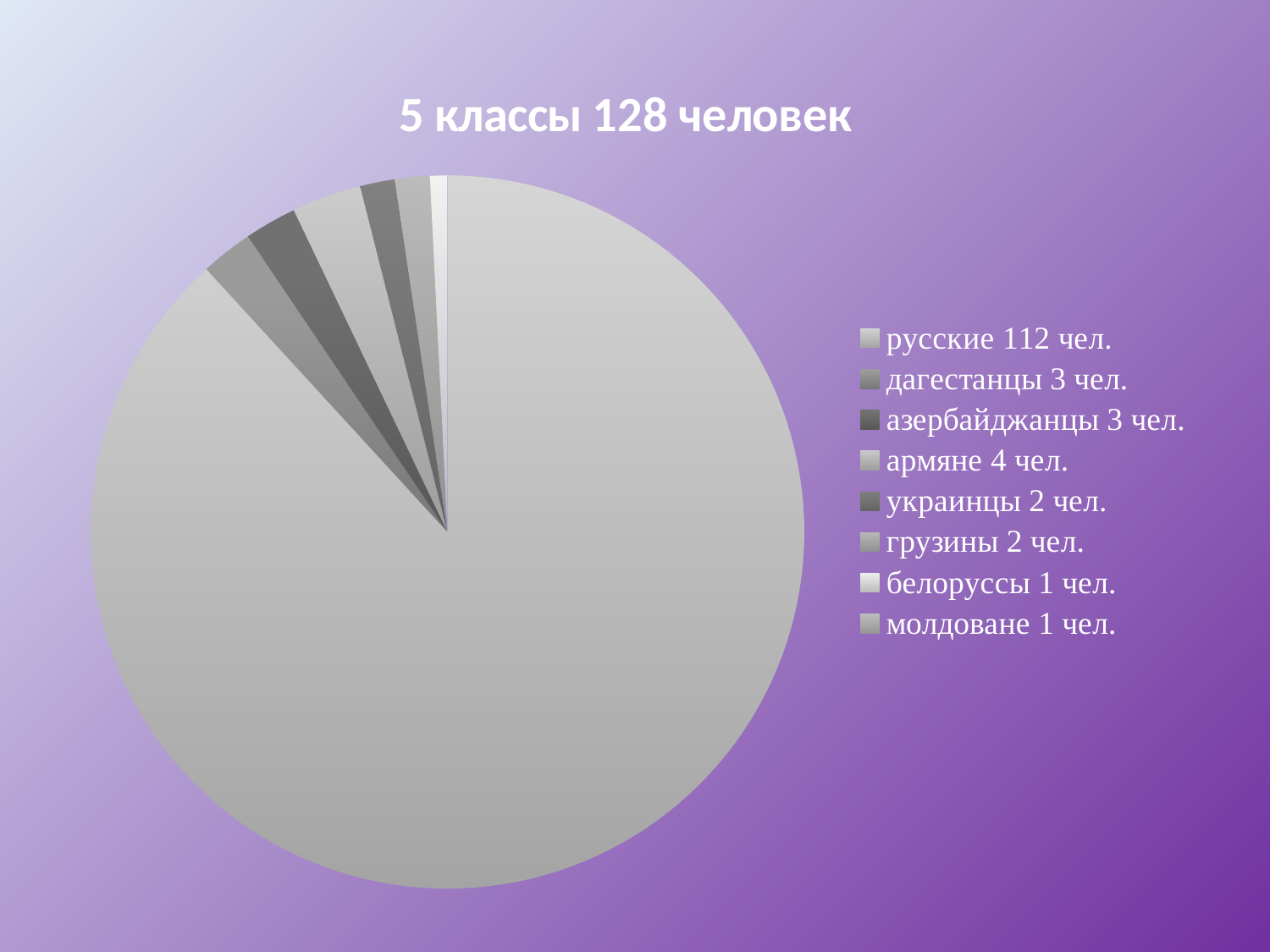
What kind of chart is shown on the slide? pie chart What is the difference between the number of дагестанцы and the number of белоруссы? 2 What is the title of the chart? 5 классы 128 человек How many people are армяне according to the legend? 4 чел. What share of the pie do русские represent? 87.5% How many people are русские according to the legend? 112 чел. What is the difference between the number of русские and the number of армяне? 108 How many categories does the pie chart have? 8 Which is larger, the value for армяне or the value for дагестанцы? армяне What is the total number of people across all categories in the pie chart? 128 Which category has the largest slice of the pie? русские How many people are украинцы according to the legend? 2 чел.